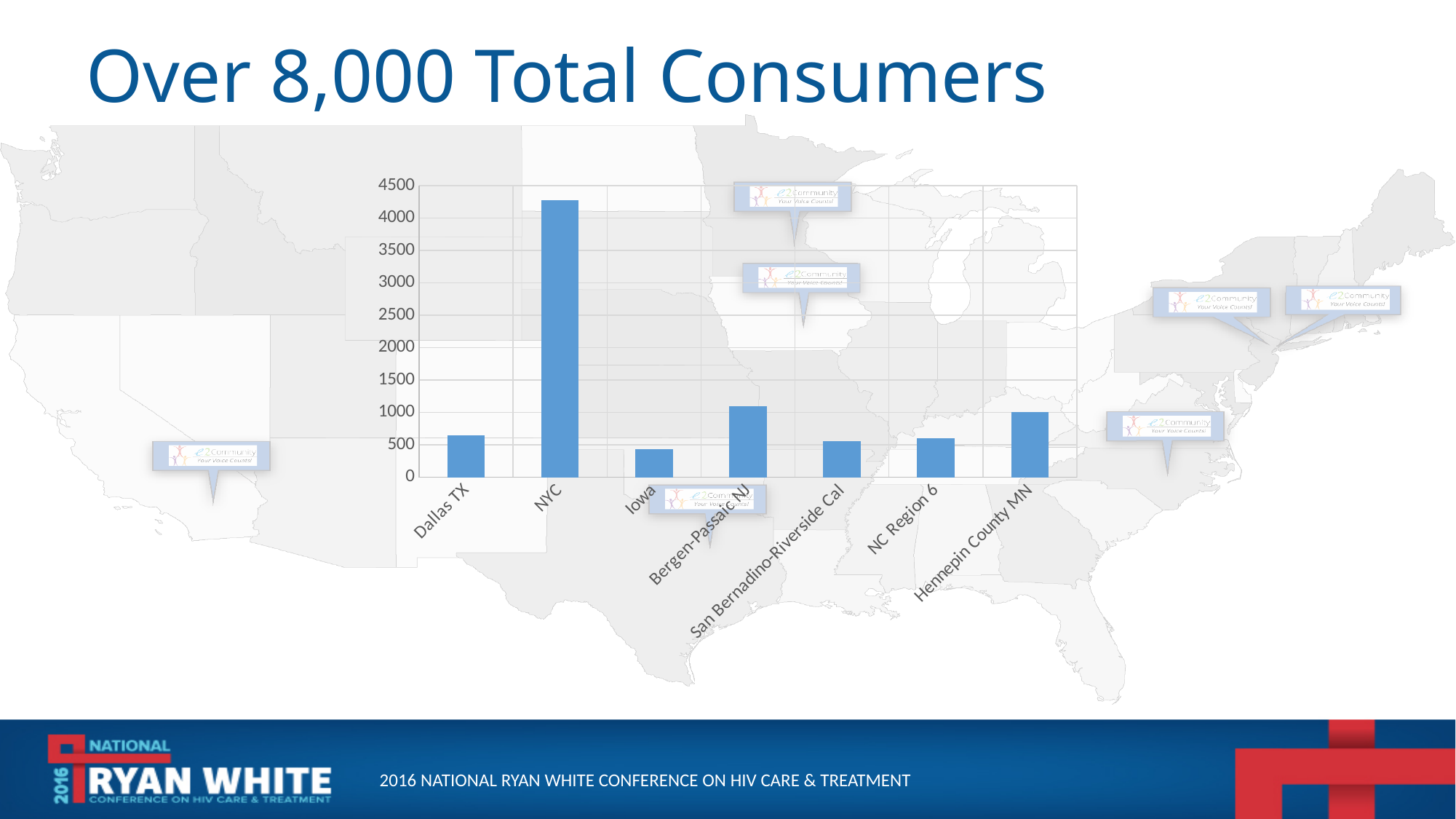
What kind of chart is shown on the slide? bar chart Is the value for Bergen-Passaic NJ greater or less than 1000? greater Is the value for NYC greater or less than 4000? greater Which is larger, the value for Bergen-Passaic NJ or the value for Iowa? Bergen-Passaic NJ How many categories are plotted on the chart? 7 Is the value for Iowa greater or less than 500? less Which category has the highest bar? NYC Which category has the lowest bar? Iowa Which is larger, the value for Hennepin County MN or the value for Dallas TX? Hennepin County MN What colour are the bars in the chart? blue What is the title of the slide containing the chart? Over 8,000 Total Consumers